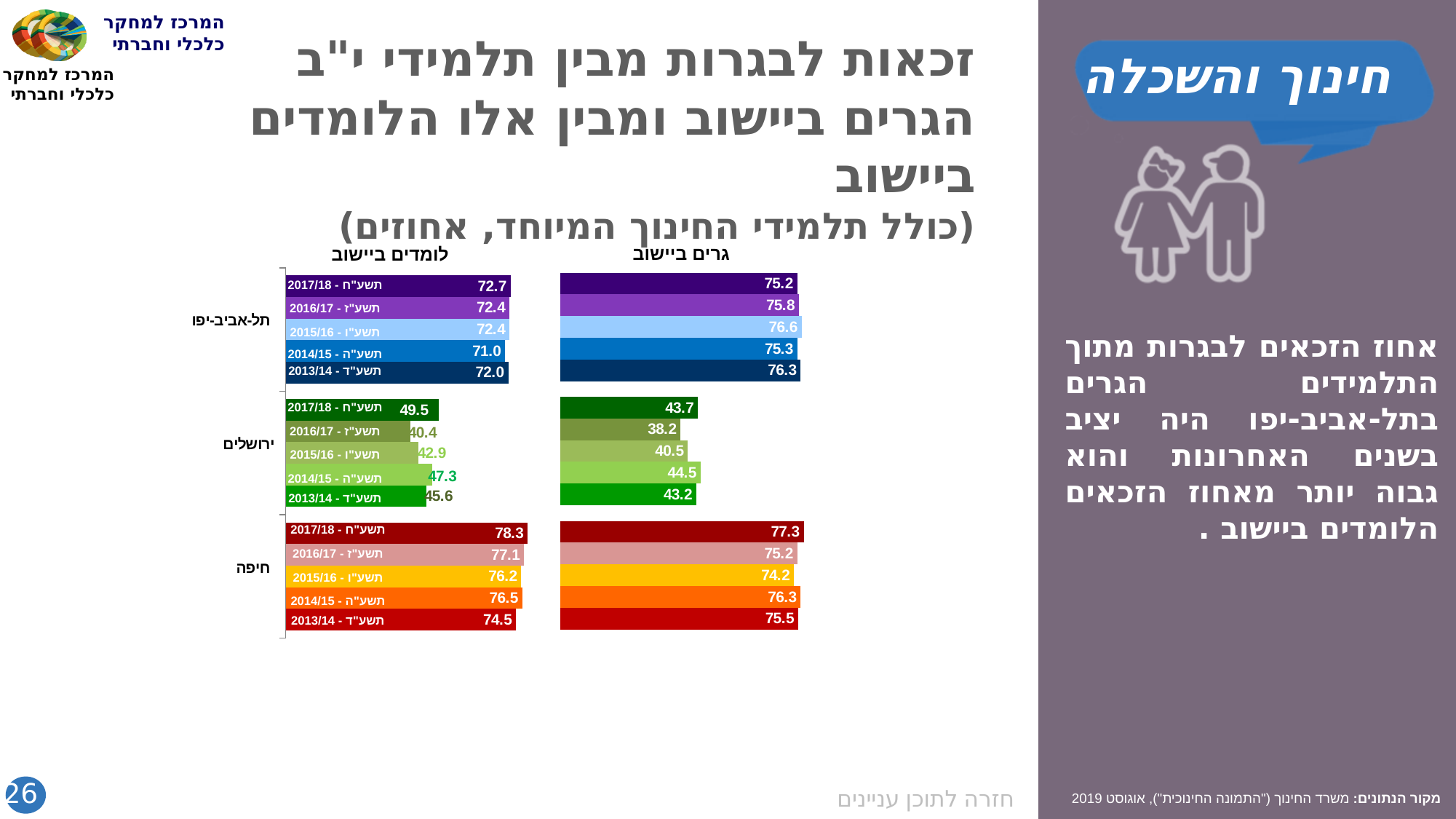
For 2017/18, is the Jerusalem (ירושלים) value larger in the "לומדים ביישוב" chart or in the "גרים ביישוב" chart? לומדים ביישוב In the chart titled "גרים ביישוב", which year has the highest value for Tel Aviv-Yafo (תל-אביב-יפו)? 2015/16 In the chart titled "לומדים ביישוב", what is the value for Tel Aviv-Yafo (תל-אביב-יפו) in 2017/18? 72.7 In the chart titled "לומדים ביישוב", what is the difference between the Haifa (חיפה) value in 2017/18 and the Tel Aviv-Yafo (תל-אביב-יפו) value in 2017/18? 5.6 In the chart titled "גרים ביישוב", what is the value for Jerusalem (ירושלים) in 2016/17? 38.2 In the chart titled "לומדים ביישוב", which year has the highest value for Haifa (חיפה)? 2017/18 How many years are shown for each city in the chart titled "לומדים ביישוב"? 5 In the chart titled "גרים ביישוב", what is the value for Haifa (חיפה) in 2013/14? 75.5 In the chart titled "גרים ביישוב", what is the difference between the Jerusalem (ירושלים) values in 2014/15 and 2016/17? 6.3 In the chart titled "לומדים ביישוב", which year has the lowest value for Jerusalem (ירושלים)? 2016/17 How many cities are shown in the chart titled "גרים ביישוב"? 3 What type of chart is the chart titled "גרים ביישוב"? Bar chart